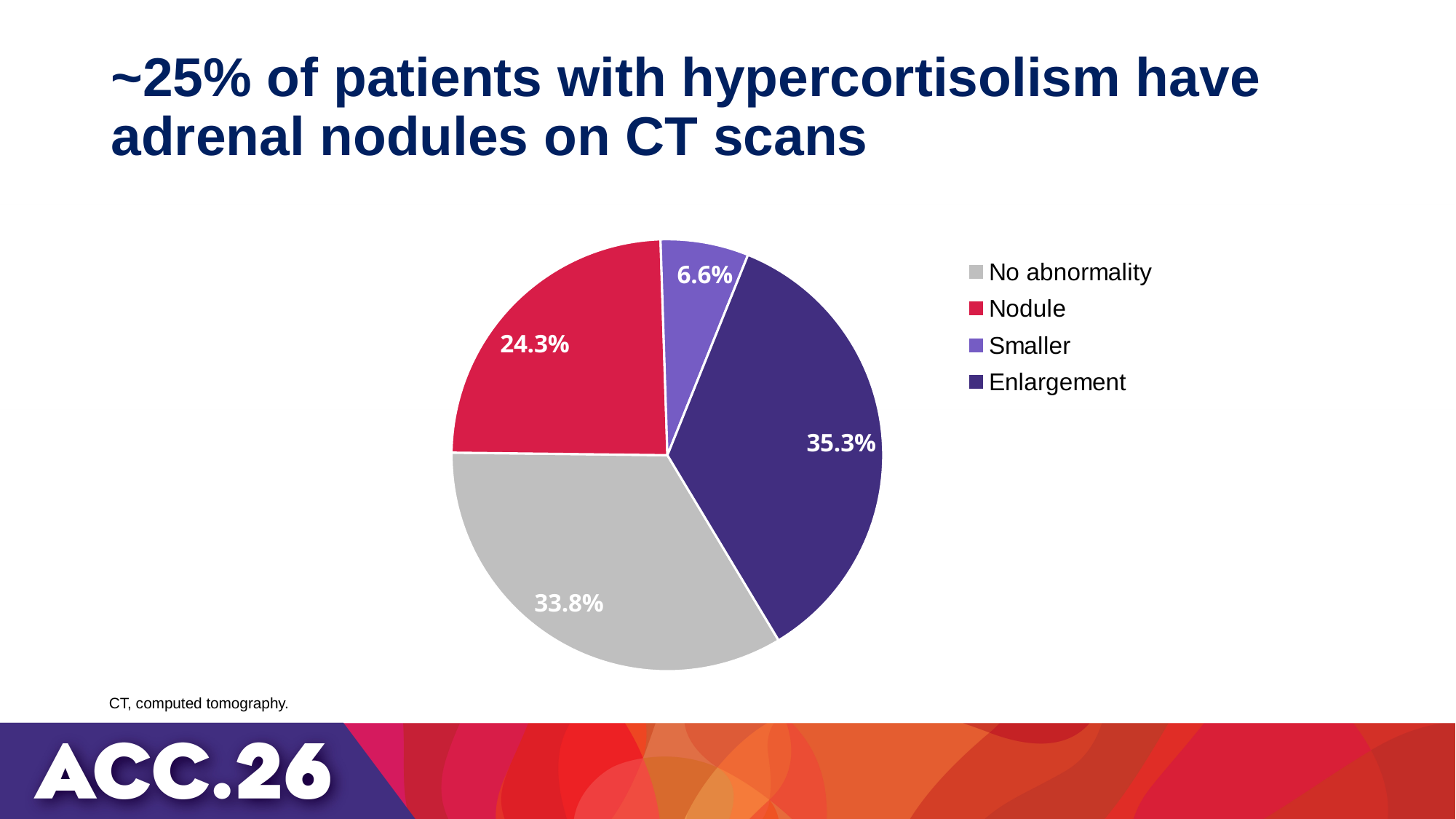
Which category has the largest slice of the pie? Enlargement What percentage of the pie is labelled for the Nodule slice? 24.3% How many categories does the pie chart show? 4 What colour is the Nodule slice in the pie chart? red Which slice is larger, No abnormality or Nodule? No abnormality What kind of chart is shown on the slide? pie chart What percentage is shown for the Enlargement slice? 35.3% What is the difference in percentage points between the Enlargement and Nodule slices? 11.0 What percentage is shown for the No abnormality slice? 33.8% Which legend entry is listed first? No abnormality Which category has the smallest slice of the pie? Smaller What percentage is shown for the Smaller slice? 6.6%